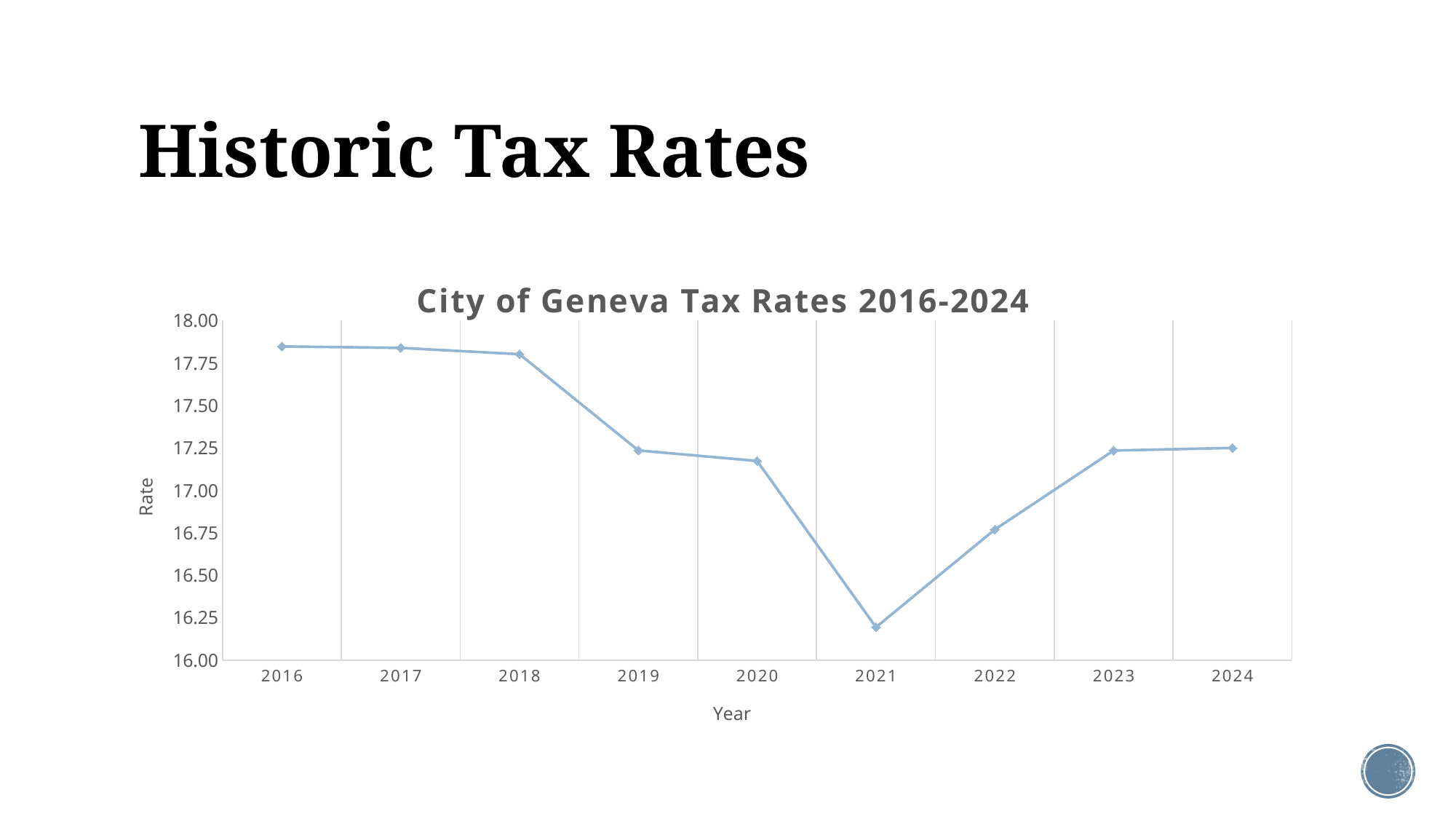
How many years are plotted on the chart? 9 Is the tax rate for 2021 greater or less than 16.50? less Is the tax rate for 2019 greater or less than 17.50? less What is the label on the vertical axis of the chart? Rate What is the title of the chart? City of Geneva Tax Rates 2016-2024 Which year has the higher tax rate, 2018 or 2019? 2018 Which year has the higher tax rate, 2022 or 2023? 2023 Which year has the lowest tax rate on the chart? 2021 What kind of chart is shown on the slide? Line chart Does the tax rate rise or fall from 2018 to 2021? fall Is the tax rate for 2022 greater or less than 16.50? greater